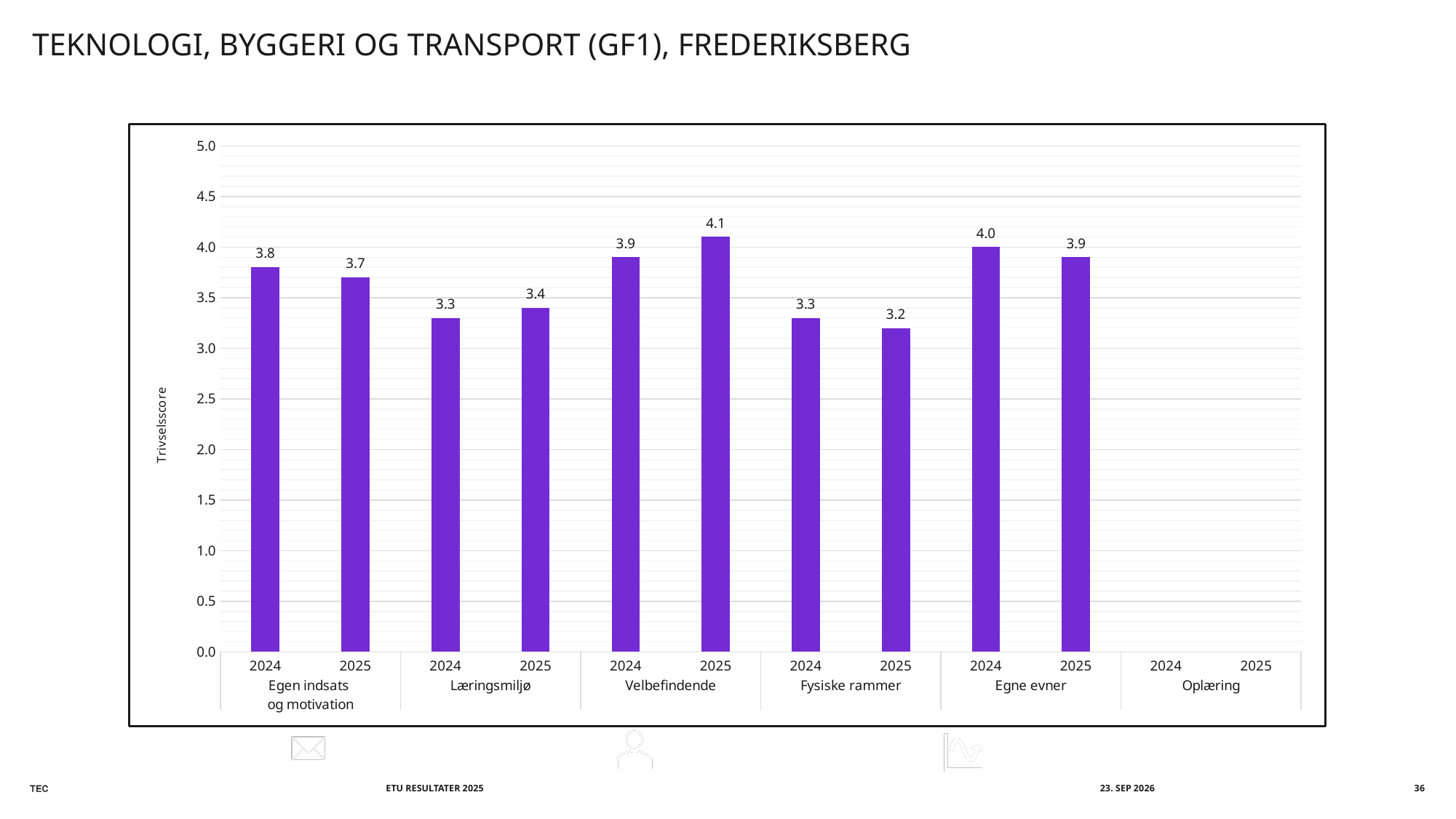
What kind of chart is shown on the slide? Bar chart What is the difference between the 2024 and 2025 Trivselsscore for Velbefindende? 0.2 What is the Trivselsscore for Velbefindende in 2025? 4.1 What is the Trivselsscore for Fysiske rammer in 2025? 3.2 What is the Trivselsscore for Egen indsats og motivation in 2024? 3.8 Is the 2025 Trivselsscore for Egne evner greater or less than 3.5? greater What is the label of the vertical axis of the chart? Trivselsscore Which bar has the lowest Trivselsscore on the chart? Fysiske rammer 2025 What is the Trivselsscore for Egne evner in 2024? 4.0 Which bar has the highest Trivselsscore on the chart? Velbefindende 2025 How many topic groups are shown on the x axis of the chart? 6 Which is larger, the 2024 or the 2025 Trivselsscore for Læringsmiljø? 2025